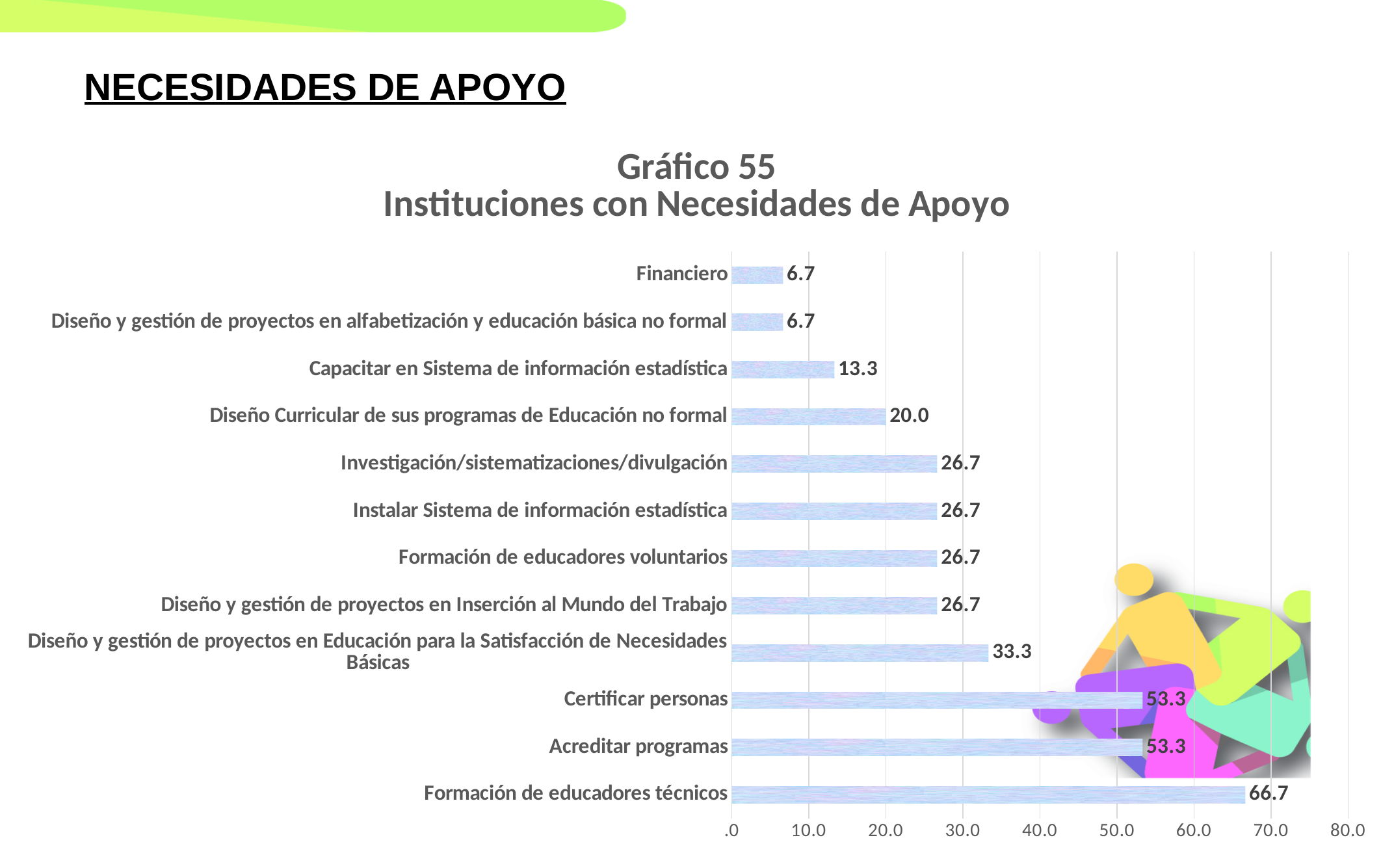
What is the value for Formación de educadores técnicos? 66.7 What is the difference between the values for Diseño y gestión de proyectos en Educación para la Satisfacción de Necesidades Básicas and Diseño Curricular de sus programas de Educación no formal? 13.3 Which category has the highest value? Formación de educadores técnicos What is the difference between the values for Formación de educadores técnicos and Acreditar programas? 13.4 What is the value for Diseño Curricular de sus programas de Educación no formal? 20.0 How many categories are shown in the chart? 12 What is the lowest value shown in the chart? 6.7 What is the value for Certificar personas? 53.3 What kind of chart is shown on the slide? bar chart What is the value for Capacitar en Sistema de información estadística? 13.3 Which is larger, the value for Acreditar programas or the value for Formación de educadores voluntarios? Acreditar programas Is the value for Certificar personas greater or less than 50.0? greater